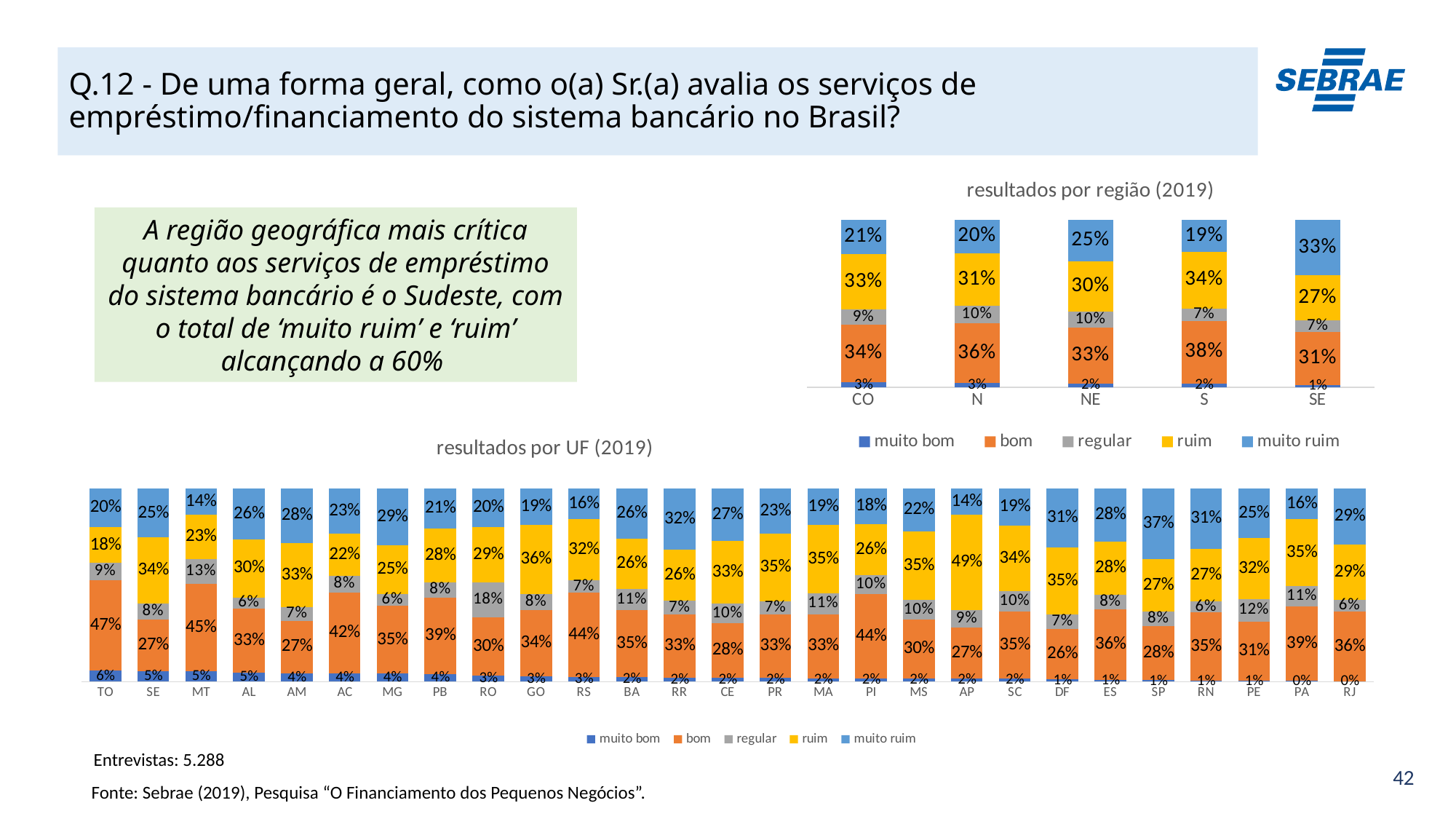
In the 'resultados por UF (2019)' chart, what is the 'bom' value for TO? 47% In the 'resultados por UF (2019)' chart, which is larger, the 'muito ruim' value for SP or for RR? SP In the 'resultados por região (2019)' chart, how many regions are shown on the x axis? 5 In the 'resultados por UF (2019)' chart, which UF has the highest 'ruim' value? AP In the 'resultados por região (2019)' chart, which region has the highest 'muito ruim' value? SE In the 'resultados por UF (2019)' chart, how many UFs are shown on the x axis? 27 What kind of chart is 'resultados por UF (2019)'? Stacked bar chart In the 'resultados por região (2019)' chart, what is the difference between the 'ruim' values for S and SE? 7% In the 'resultados por região (2019)' chart, what is the 'muito ruim' value for SE? 33% In the 'resultados por região (2019)' chart, what is the 'bom' value for S? 38% How many series does the legend of the 'resultados por região (2019)' chart list? 5 In the 'resultados por região (2019)' chart, which region has the lowest 'muito bom' value? SE